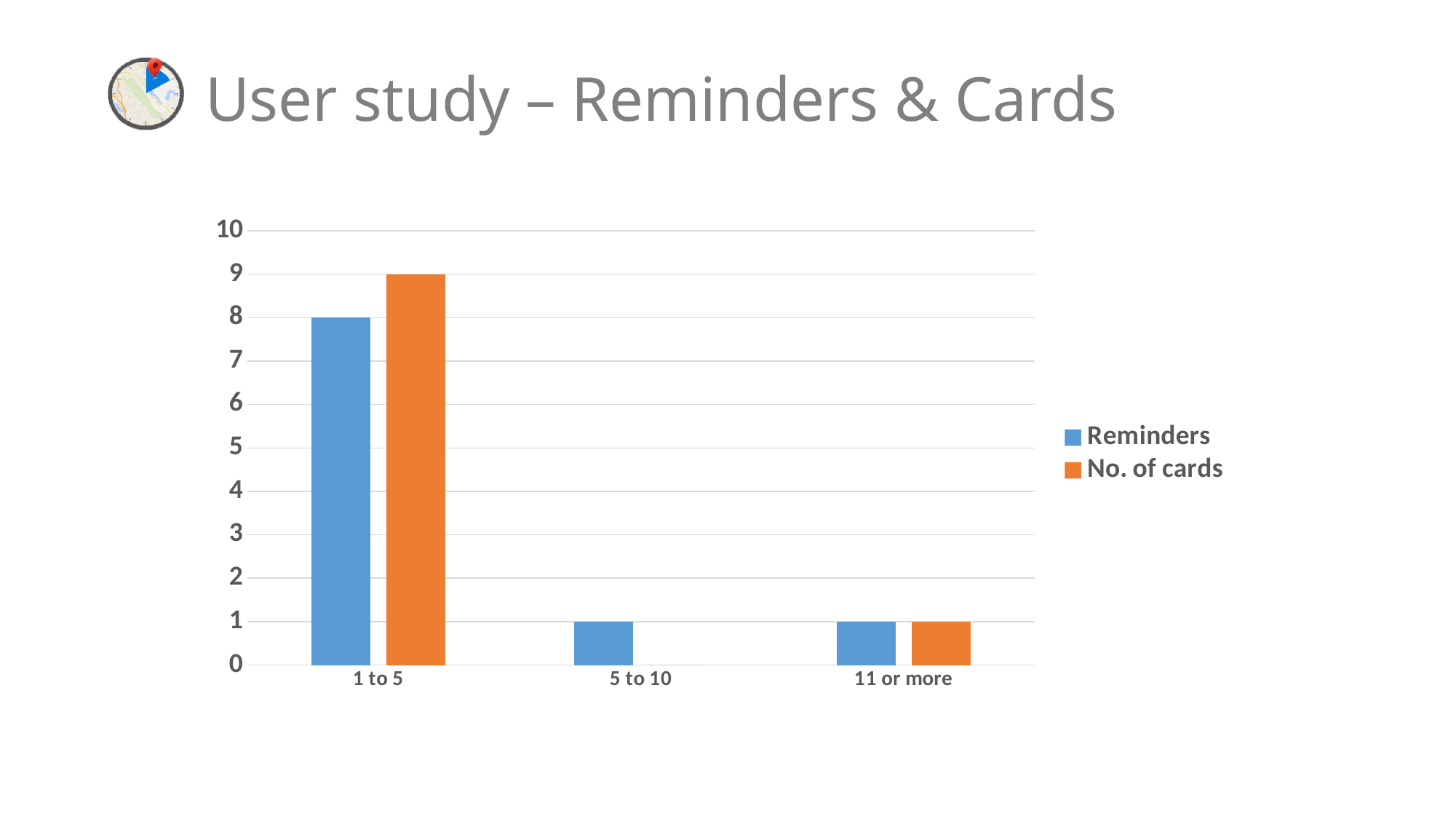
What is the No. of cards value for the '1 to 5' category? 9 How many categories are shown on the x axis? 3 What is the No. of cards value for the '11 or more' category? 1 Which category has the highest Reminders value? 1 to 5 For the '1 to 5' category, which is larger: Reminders or No. of cards? No. of cards What type of chart is shown on the slide? bar chart What is the Reminders value for the '1 to 5' category? 8 Which colour represents the No. of cards series in the legend? orange How many series does the legend list? 2 What is the Reminders value for the '5 to 10' category? 1 Do the Reminders values rise or fall from '1 to 5' to '11 or more' along the x axis? fall What is the difference between the No. of cards and Reminders values for the '1 to 5' category? 1